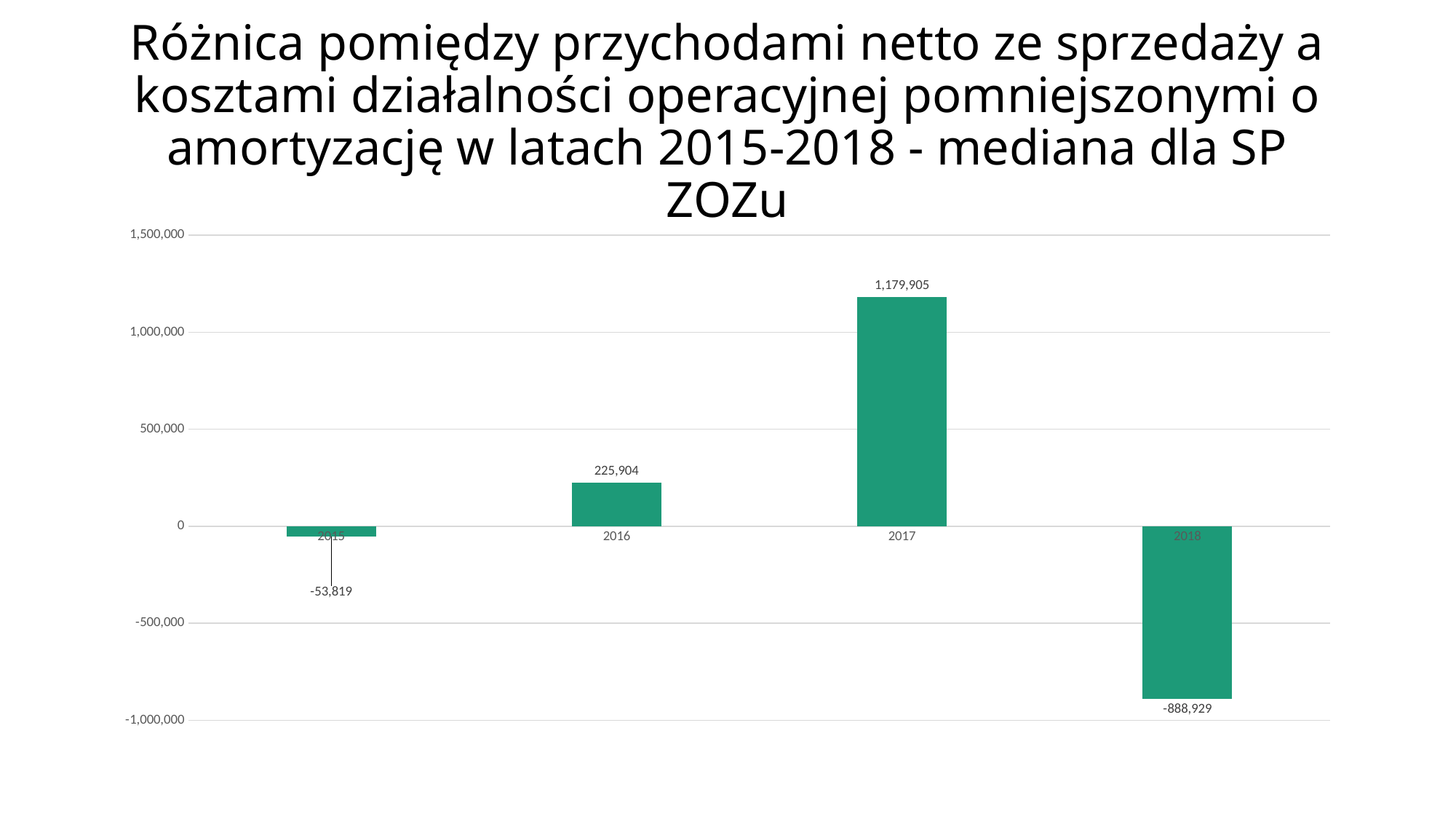
How many years are shown on the chart? 4 What is the value for 2016? 225,904 How many years have a negative value? 2 What is the value for 2015? -53,819 What is the difference between the values for 2017 and 2016? 954,001 Which year has the lowest value? 2018 What kind of chart is shown on the slide? bar chart What is the value for 2018? -888,929 Is the value for 2017 greater or less than 1,000,000? greater Which year has the highest value? 2017 Which is larger, the value for 2016 or the value for 2015? 2016 What is the value for 2017? 1,179,905